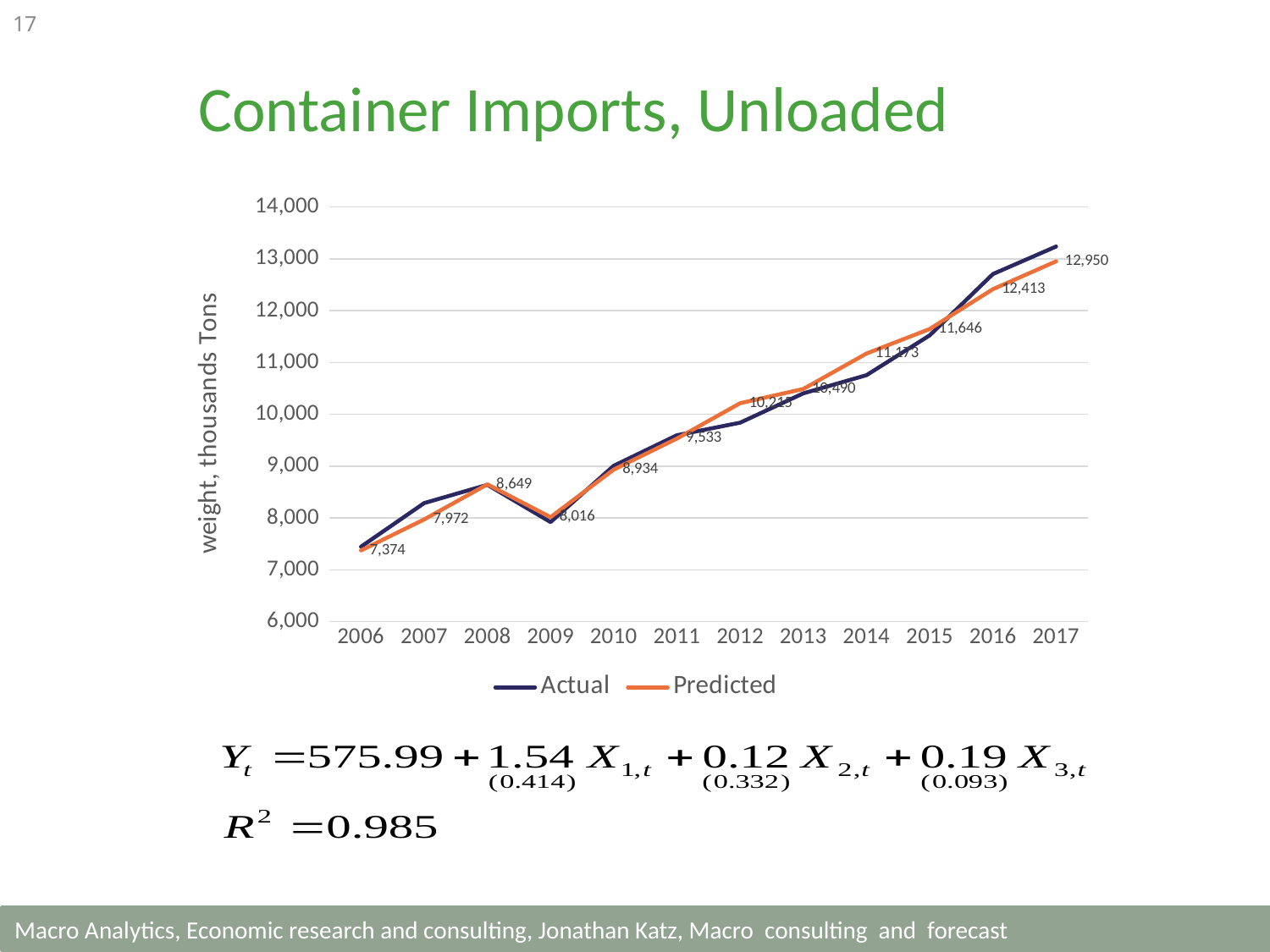
What kind of chart is shown on the slide? line chart By how much does the Predicted value increase from 2016 to 2017? 537 What is the Predicted value for 2009? 8,016 How many years are shown on the x axis? 12 In 2017, which series has the higher value, Actual or Predicted? Actual What is the Predicted value for 2006? 7,374 In which year is the Predicted value lowest? 2006 How many series does the legend list? 2 Is the Actual value for 2017 greater or less than 13,000? greater Is the Actual value for 2007 greater or less than 8,000? greater What is the Predicted value for 2017? 12,950 What is the difference between the Predicted values for 2008 and 2007? 677